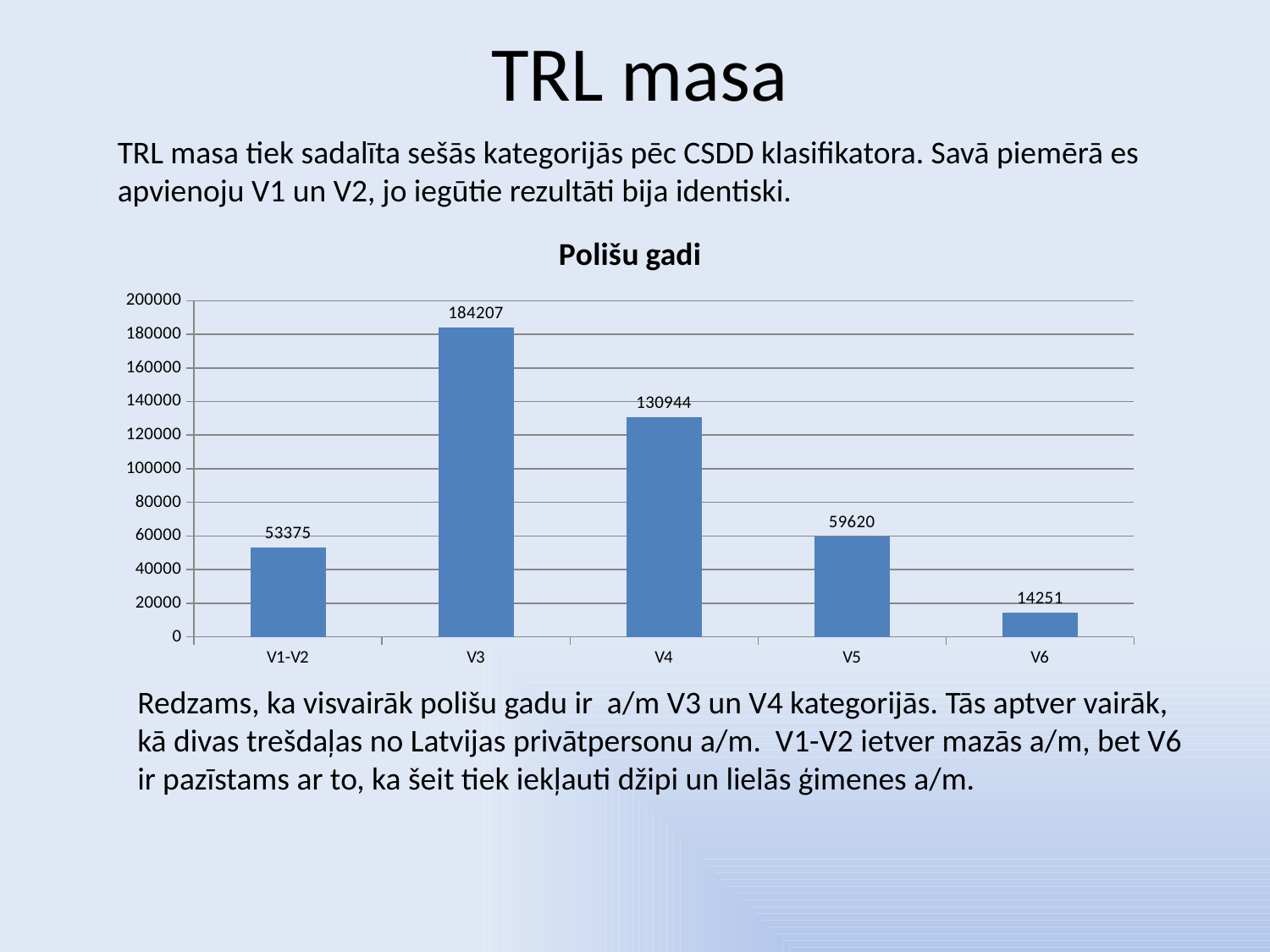
What is the value for V6 in the Polišu gadi chart? 14251 Which category has the lowest value in the Polišu gadi chart? V6 Is the value for V4 in the Polišu gadi chart greater or less than 120000? greater What kind of chart is the Polišu gadi chart? bar chart What is the title of the chart on the slide? Polišu gadi Which is larger in the Polišu gadi chart, the value for V5 or the value for V1-V2? V5 Which category has the highest value in the Polišu gadi chart? V3 How many categories are shown on the x axis of the Polišu gadi chart? 5 What is the value for V1-V2 in the Polišu gadi chart? 53375 What is the difference between the values for V3 and V4 in the Polišu gadi chart? 53263 What is the value for V3 in the Polišu gadi chart? 184207 What is the value for V5 in the Polišu gadi chart? 59620